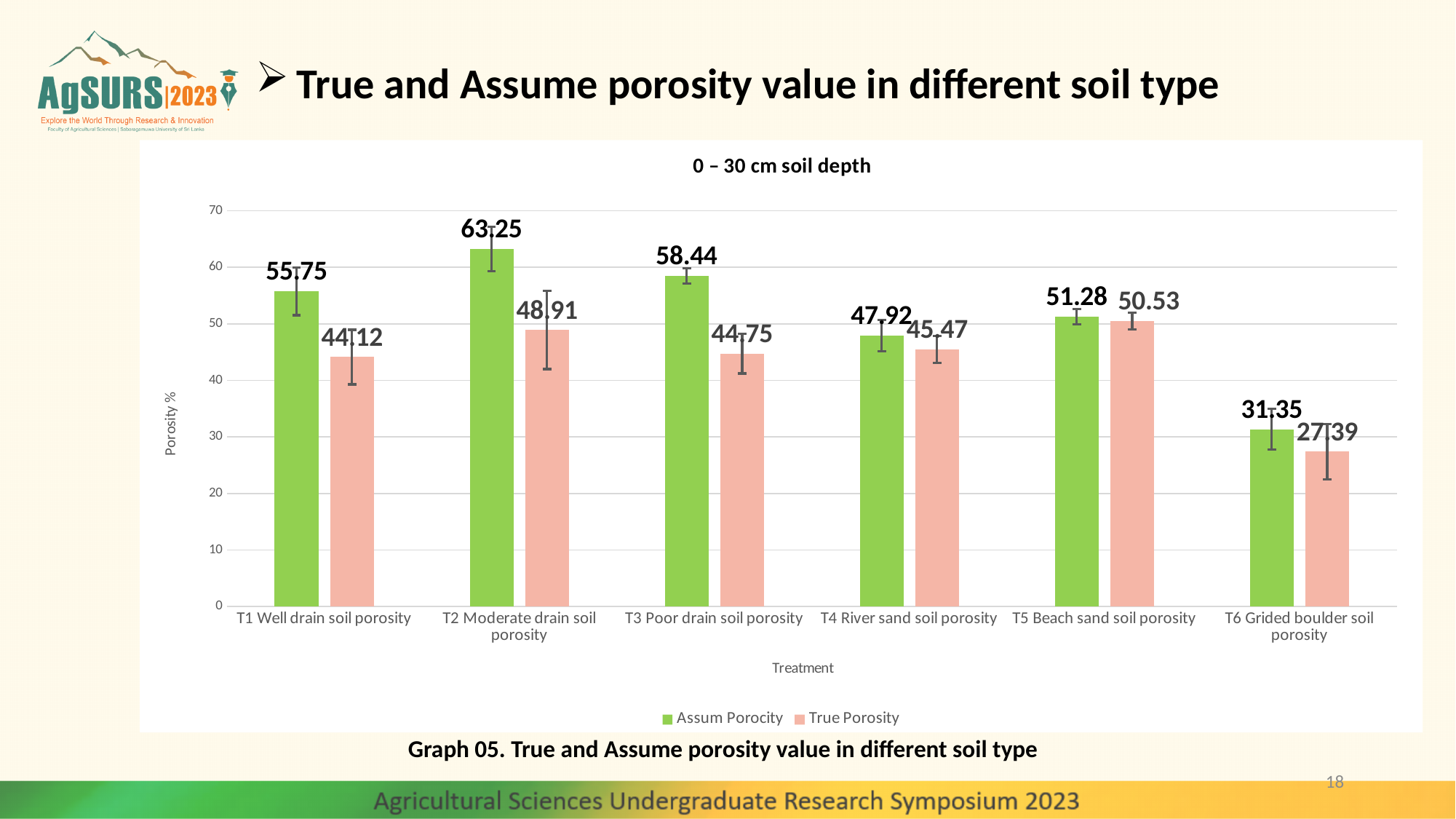
What is the True Porosity value for T6 Grided boulder soil porosity? 27.39 What kind of chart is shown on the slide? Bar chart Is the Assum Porocity value for T3 Poor drain soil porosity greater or less than 50? greater How many treatments are shown on the x axis? 6 What is the True Porosity value for T5 Beach sand soil porosity? 50.53 What is the difference between the Assum Porocity and True Porosity values for T1 Well drain soil porosity? 11.63 How many series does the legend list? 2 What is the title shown above the chart? 0 – 30 cm soil depth Which treatment has the lowest True Porosity value? T6 Grided boulder soil porosity Which is larger for T5 Beach sand soil porosity: Assum Porocity or True Porosity? Assum Porocity Which treatment has the highest Assum Porocity value? T2 Moderate drain soil porosity What is the Assum Porocity value for T2 Moderate drain soil porosity? 63.25